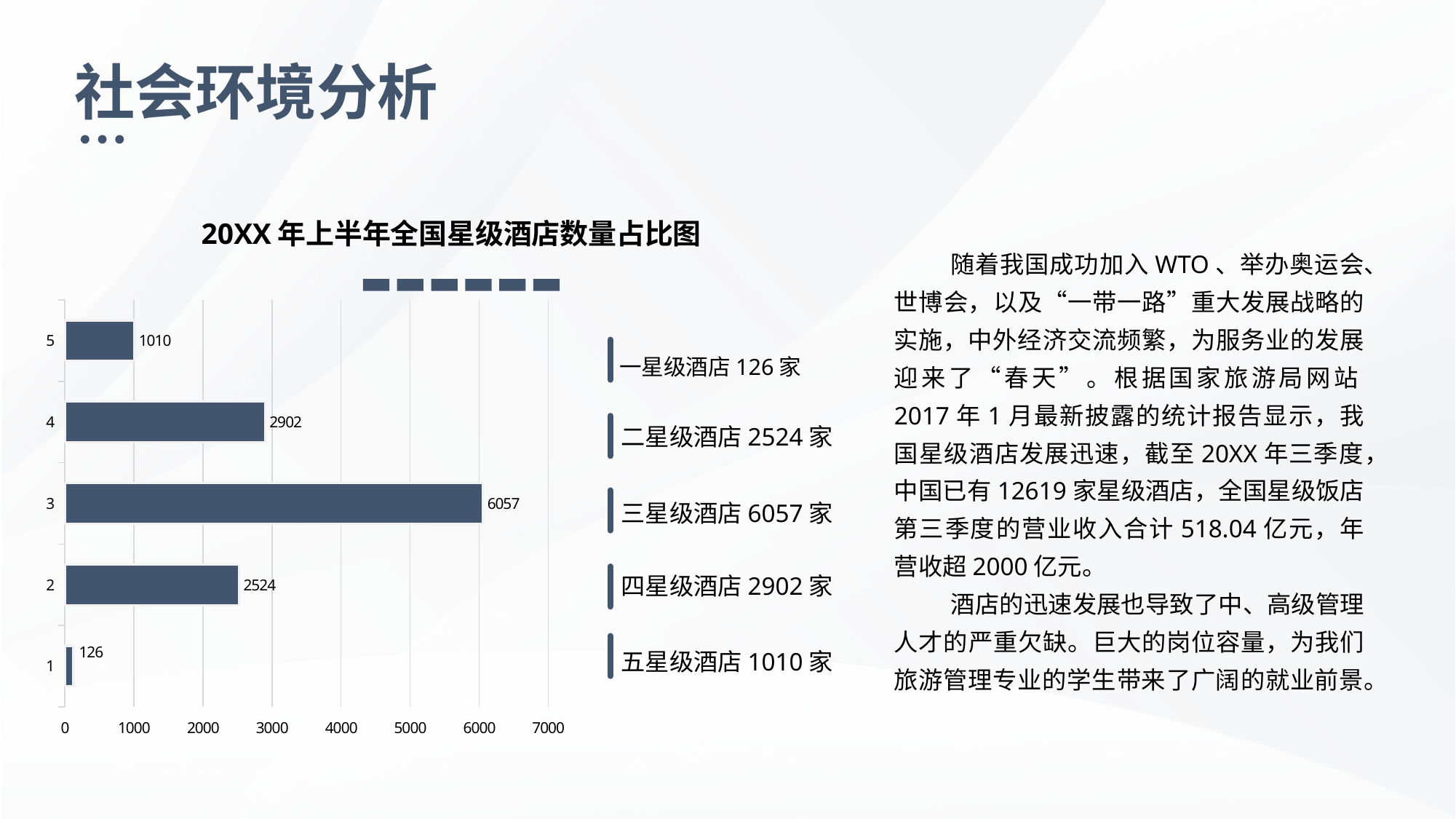
What is the maximum value shown on the horizontal axis? 7000 What is the value for category 1? 126 How many bars does the chart have? 5 What is the value for category 5? 1010 Which category has the lowest value? 1 What is the title of the chart? 20XX 年上半年全国星级酒店数量占比图 What type of chart is shown on the slide? bar chart Which category has the highest value? 3 Is the value for category 3 greater or less than 6000? greater What is the value for category 3? 6057 Which is larger, the value for category 4 or the value for category 5? category 4 What is the difference between the values for category 4 and category 2? 378